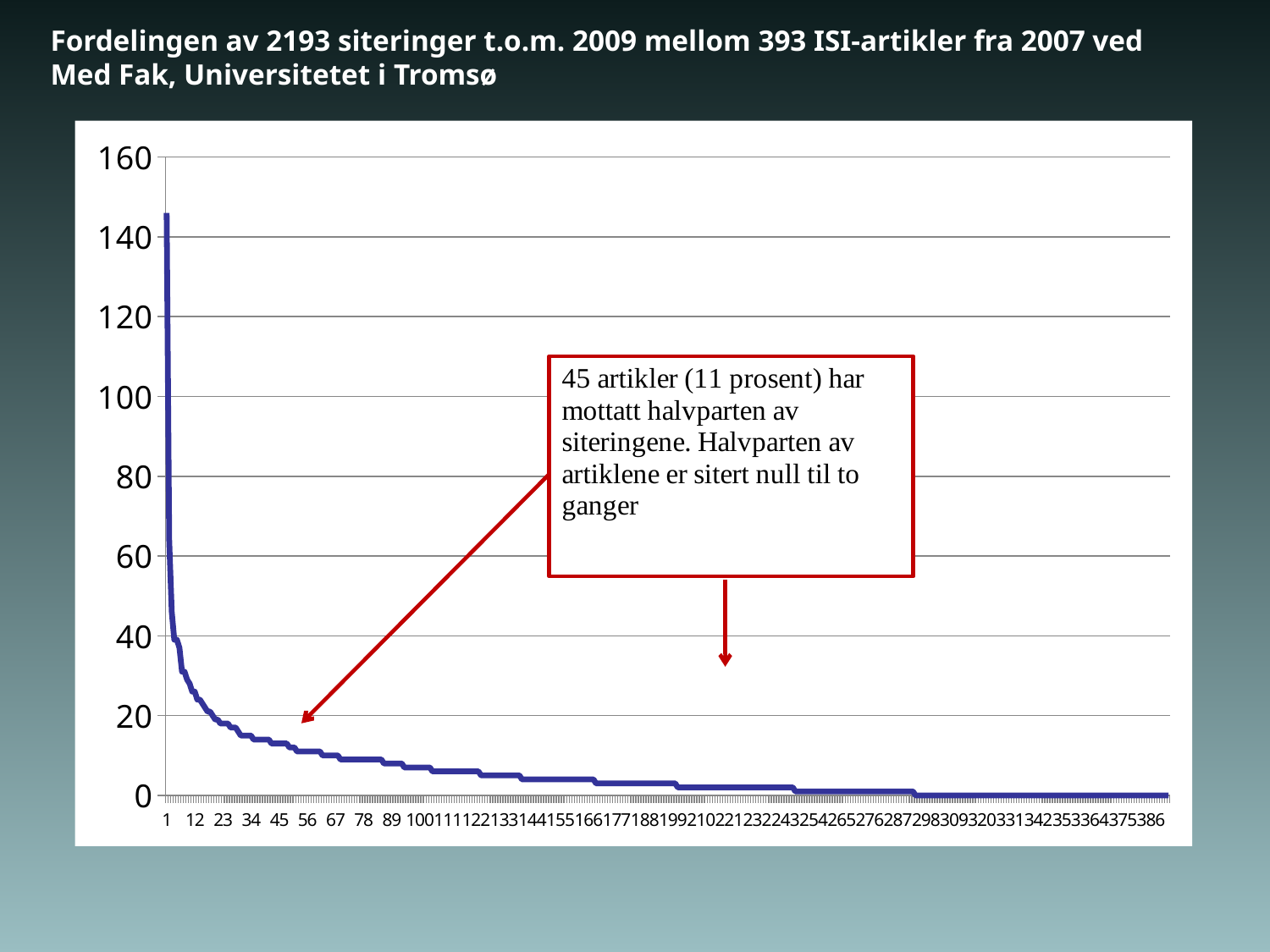
Is the value for article 1 greater or less than 140? greater Is the value for article 12 greater or less than 40? less What is the highest value shown on the y axis? 160 Which has the larger value, article 12 or article 100? article 12 According to the slide title, how many ISI articles from 2007 are included in the distribution? 393 What kind of chart is shown on the slide? line chart Which article number on the x axis has the highest number of citations? 1 Do the values rise or fall as you move from left to right along the x axis? fall Is the value for article 56 greater or less than 20? less Which has the larger value, article 1 or article 386? article 1